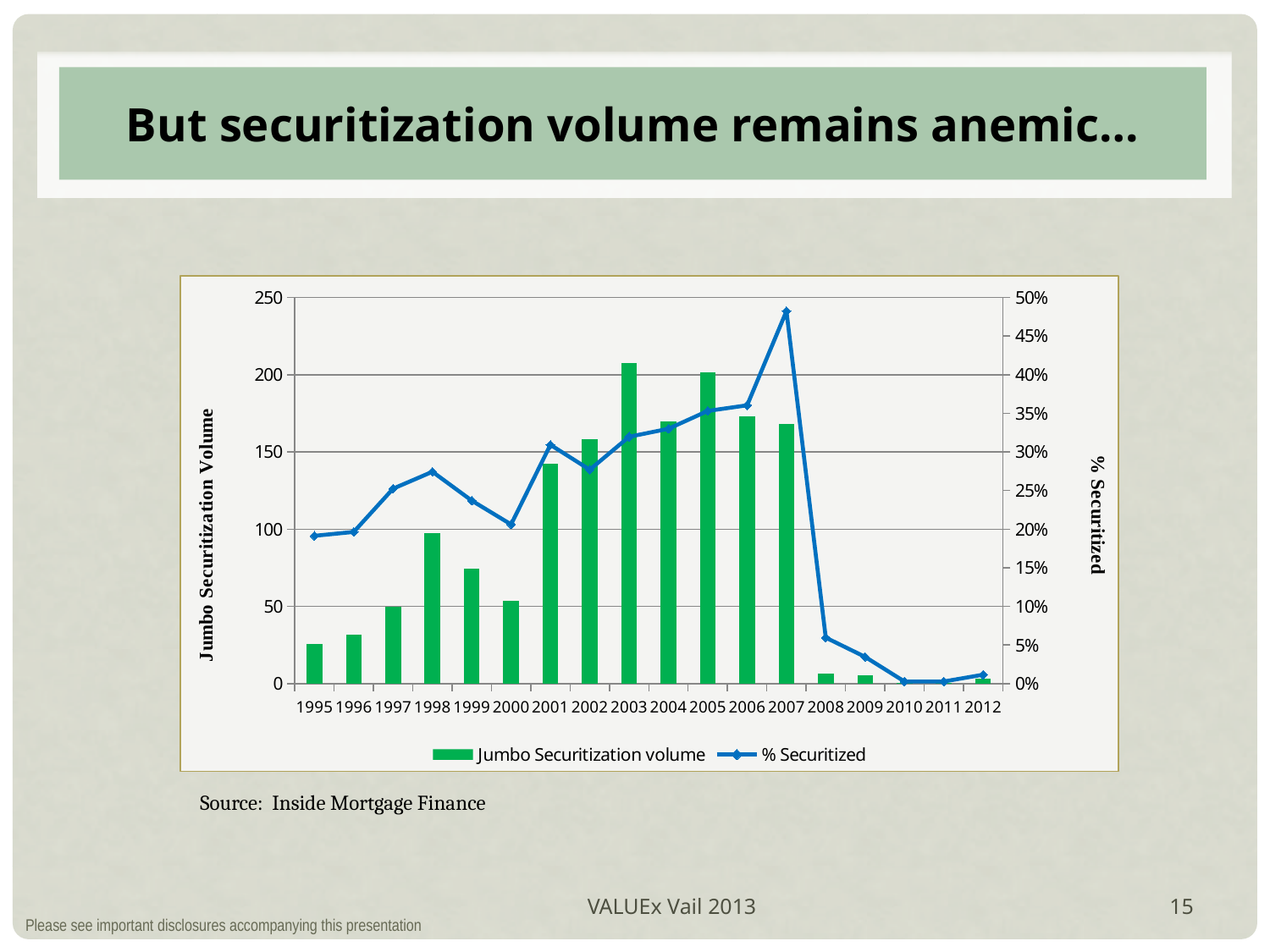
What kind of chart is shown on the slide? Combined bar and line chart How many series does the legend list? 2 In which year does the % Securitized line reach its highest point? 2007 Is the Jumbo Securitization volume for 1998 greater or less than 100? less Is the % Securitized value for 2008 greater or less than 10%? less How many years are shown on the x axis? 18 Does the % Securitized line rise or fall from 2007 to 2011? fall Is the Jumbo Securitization volume for 2003 greater or less than 200? greater What is the label of the right-hand vertical axis? % Securitized Which year has the larger Jumbo Securitization volume, 2003 or 1995? 2003